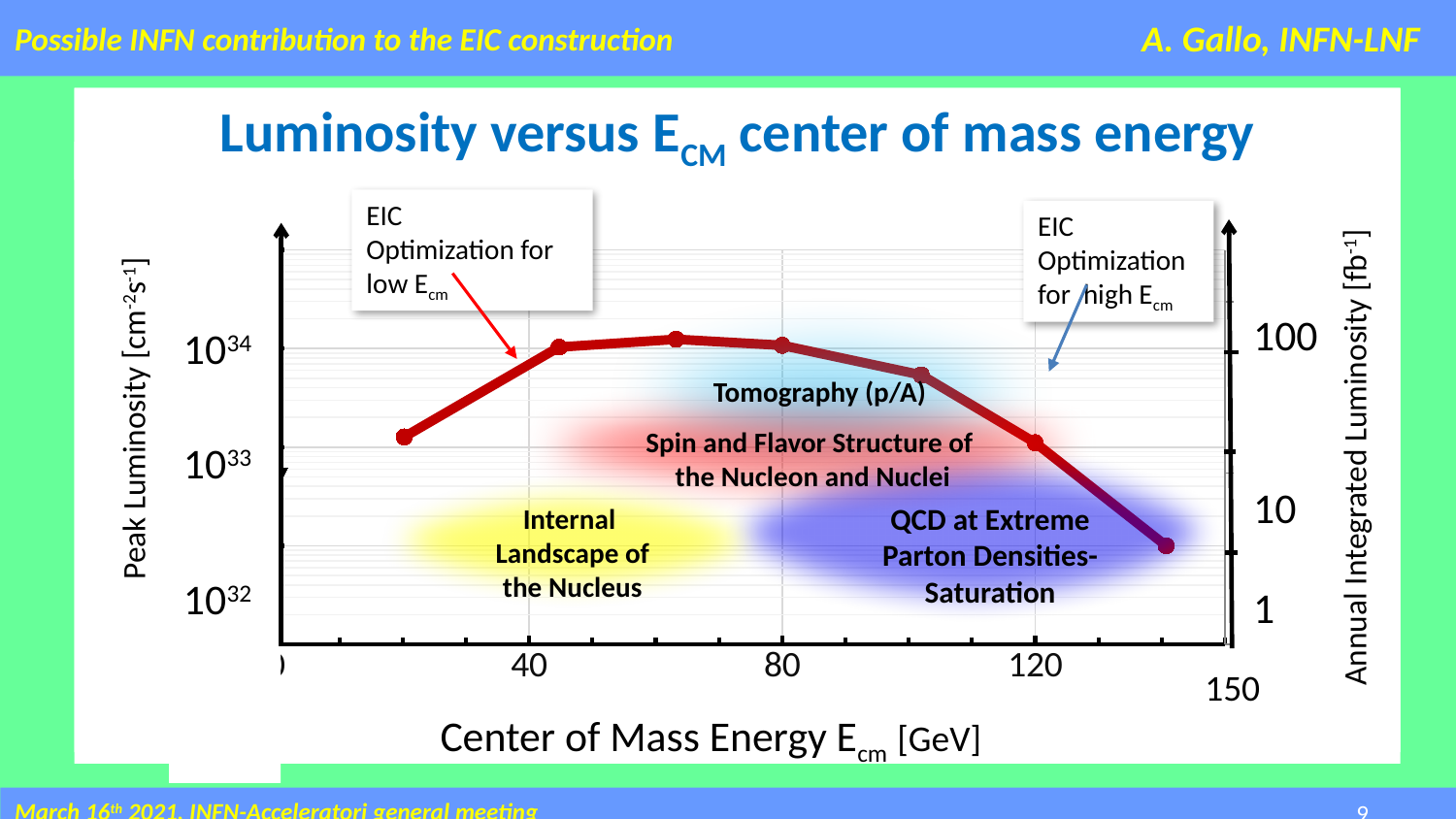
Which has the higher peak luminosity, the point at 80 GeV or the point at 120 GeV? 80 GeV What kind of chart is shown on the slide? line chart What quantity is shown on the right-hand vertical axis? Annual Integrated Luminosity [fb^-1] Is the peak luminosity at 120 GeV greater or less than 10^34 cm^-2 s^-1? less What is the title of the chart? Luminosity versus E_CM center of mass energy Is the peak luminosity at 120 GeV greater or less than 10^33 cm^-2 s^-1? greater Is the peak luminosity at the highest-energy point (near 140 GeV) greater or less than 10^33 cm^-2 s^-1? less Does the peak luminosity rise or fall as the center of mass energy increases from 120 GeV to 150 GeV? fall How many data points are plotted on the luminosity curve? 7 Does the peak luminosity rise or fall as the center of mass energy increases from 20 GeV to 40 GeV? rise Is the lowest peak luminosity on the curve found at the low-energy end or the high-energy end? high-energy end